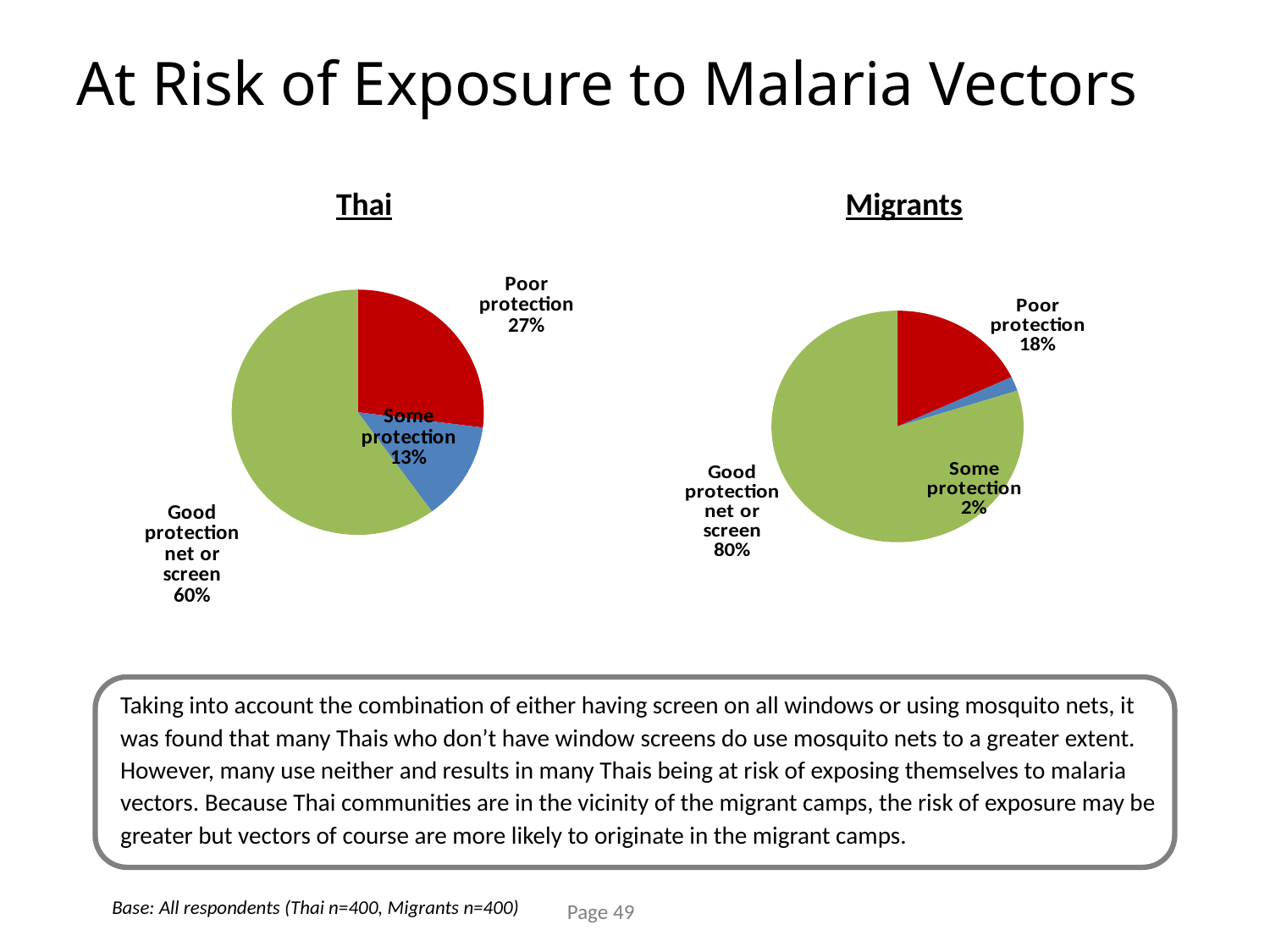
How many slices does the Thai pie chart have? 3 Which is larger: the Poor protection share in the Thai chart or the Poor protection share in the Migrants chart? Thai In the Thai pie chart, which category has the largest slice? Good protection net or screen What colour is the Good protection net or screen slice in the Thai pie chart? Green What kind of chart is used for the Migrants data? Pie chart In the Migrants pie chart, what is the combined share of Poor protection and Some protection? 20% In the Thai pie chart, what is the difference between the Poor protection share and the Some protection share? 14% In the Migrants pie chart, which category has the smallest slice? Some protection In the Migrants pie chart, what share is labelled Good protection net or screen? 80% What is the title of the slide? At Risk of Exposure to Malaria Vectors In the Thai pie chart, what share is labelled Poor protection? 27% In the Migrants pie chart, what share is labelled Some protection? 2%